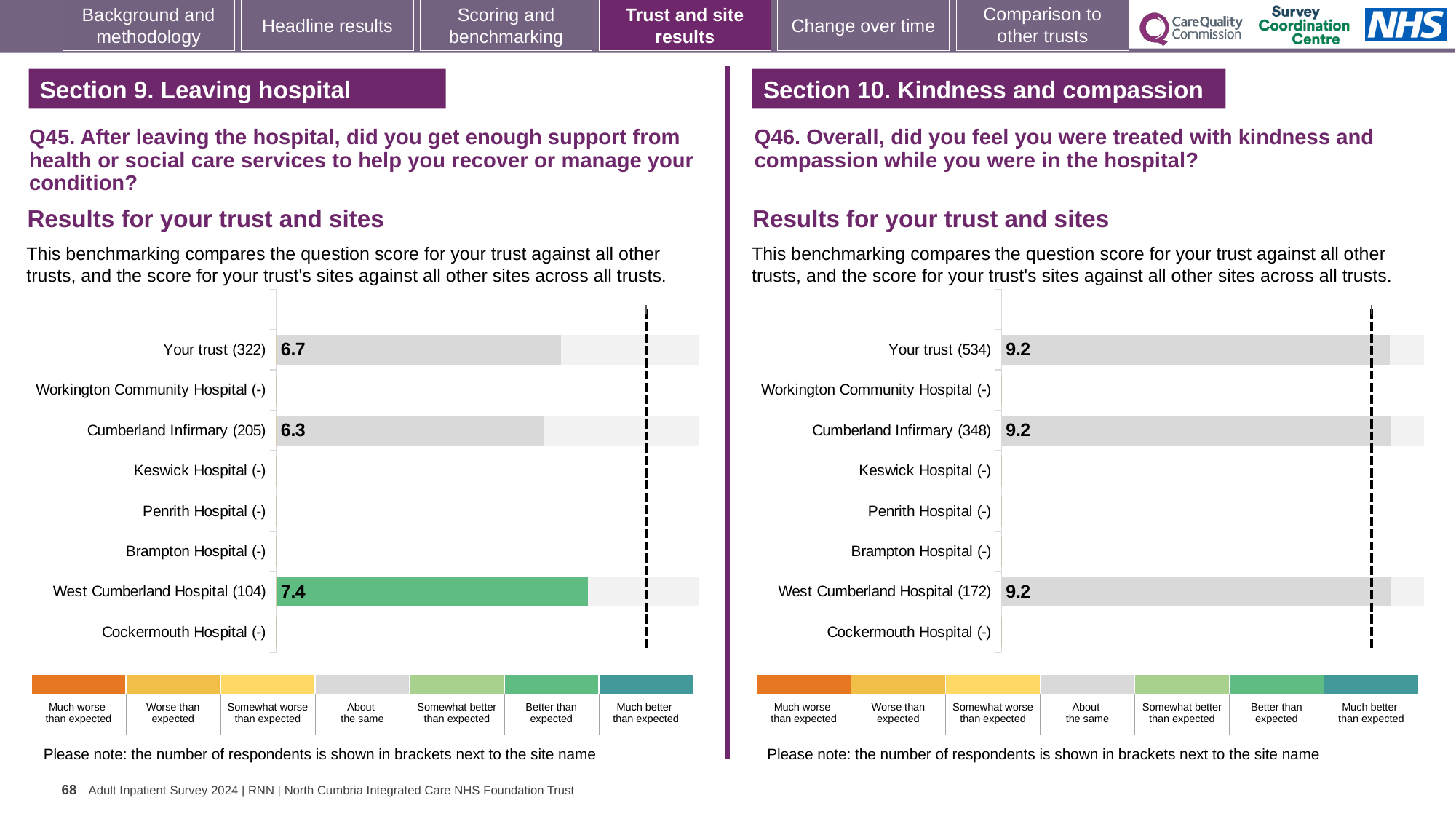
In the Q45 chart on the left, which benchmark category does the green colour of the West Cumberland Hospital bar represent? Better than expected In the Q45 chart on the left, which is larger: the score for Your trust or the score for Cumberland Infirmary? Your trust What kind of chart is used in the Q45 chart on the left? Bar chart In the Q45 chart on the left, what is the difference between the scores for West Cumberland Hospital and Cumberland Infirmary? 1.1 In the Q45 chart on the left, which site has the highest score? West Cumberland Hospital In the Q45 chart on the left, which site has the lowest printed score? Cumberland Infirmary How many site rows (categories) are listed in the Q46 chart on the right? 8 In the Q45 chart on the left, what is the score for Cumberland Infirmary? 6.3 In the Q46 chart on the right, what is the score for Your trust? 9.2 In the Q45 chart on the left, what is the score for West Cumberland Hospital? 7.4 In the Q46 chart on the right, what is the score for West Cumberland Hospital? 9.2 In the Q45 chart on the left, what is the score for Your trust? 6.7